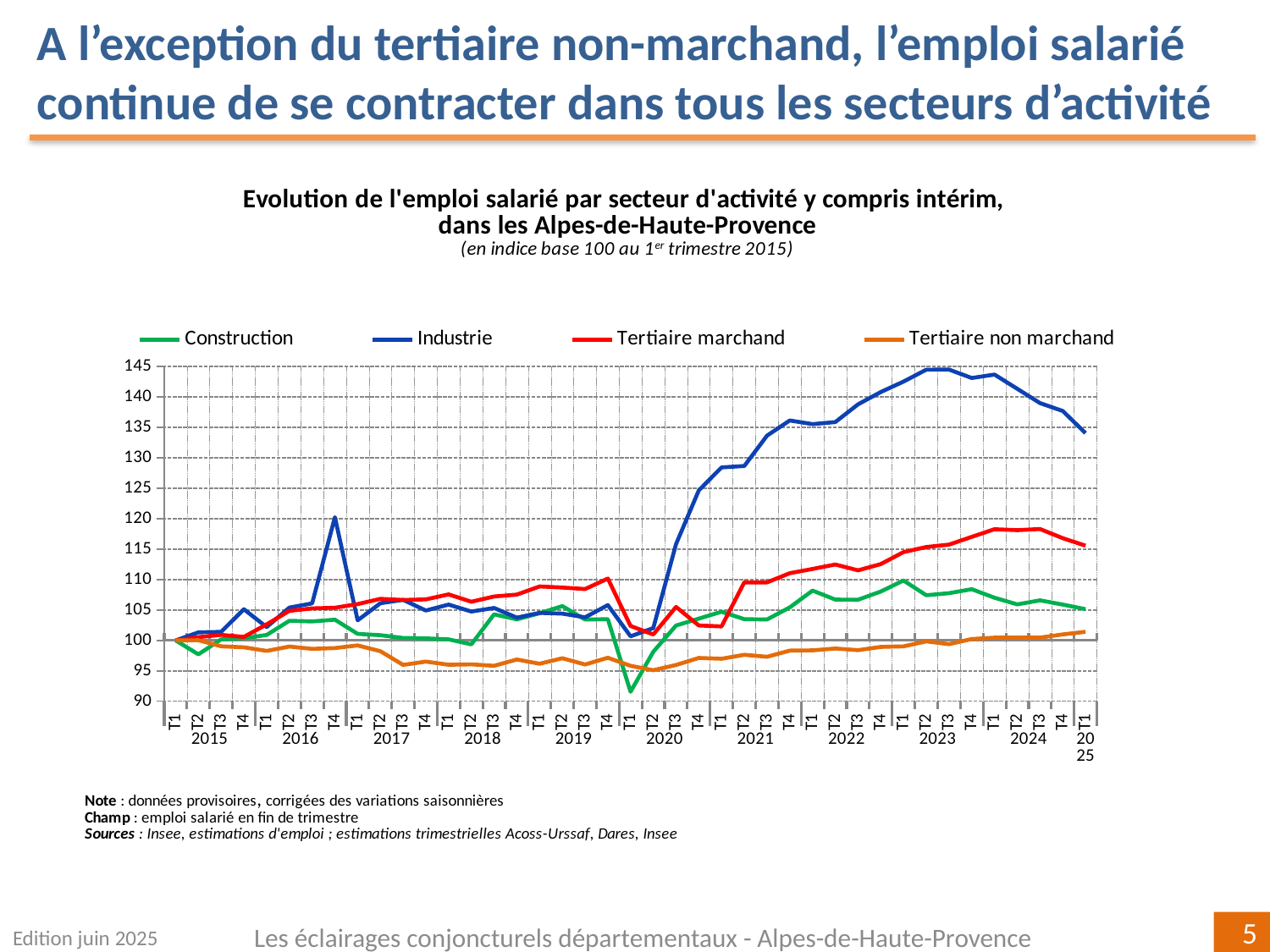
Which series has the lowest value at T1 2025? Tertiaire non marchand Is the value for Construction at T1 2020 greater or less than 95? less At T1 2025, which is larger: Industrie or Tertiaire marchand? Industrie Is the value for Tertiaire marchand at T1 2025 greater or less than 110? greater Is the peak value of Industrie in 2023 greater or less than 140? greater Which series is plotted in blue? Industrie How many series does the legend list? 4 Does the Industrie series rise or fall between T1 2024 and T1 2025? fall What kind of chart is shown on the slide? line chart Which series drops the lowest in the first quarter of 2020? Construction Which series has the highest value at T1 2025? Industrie